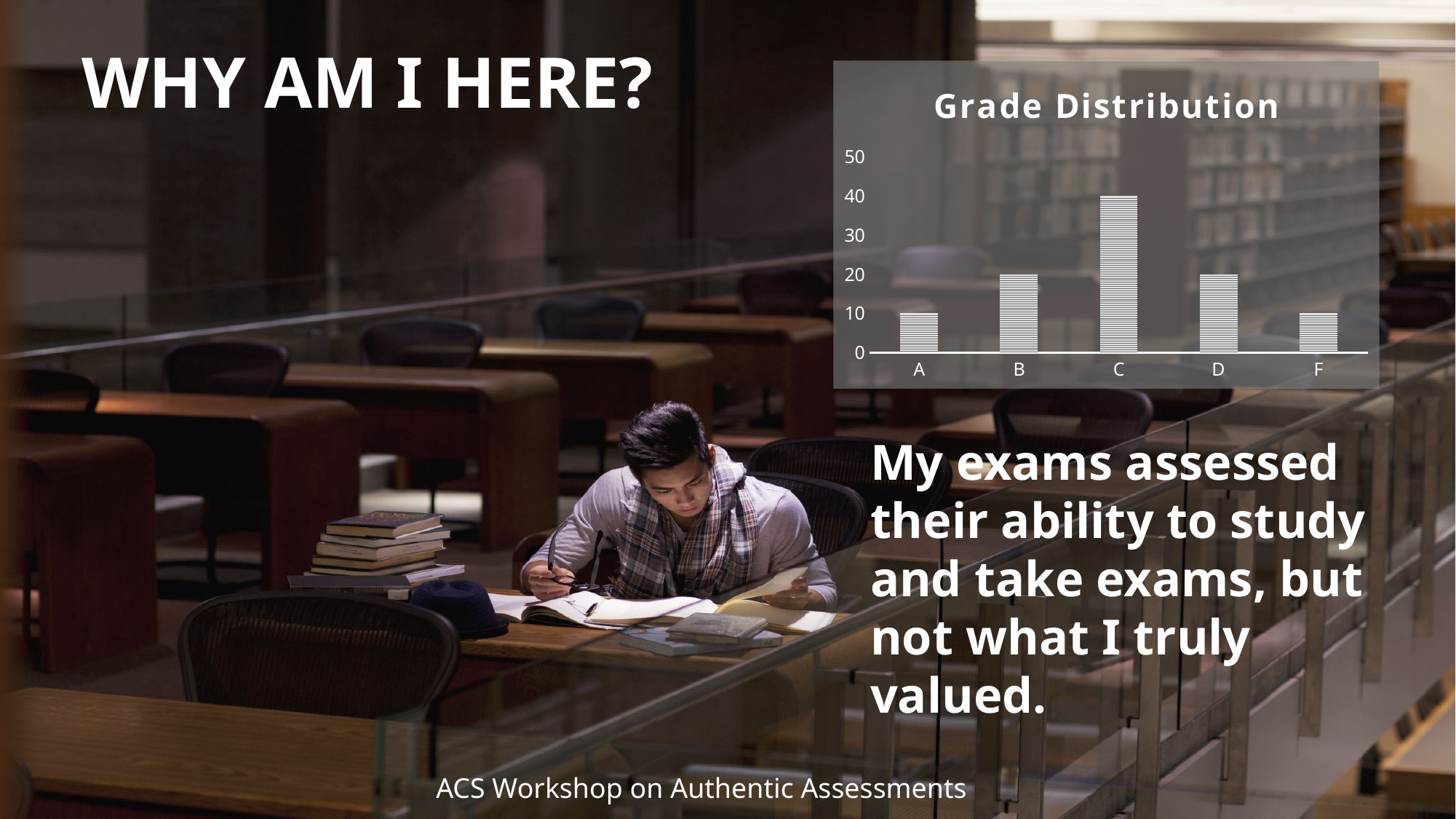
How many grade categories are shown on the x axis of the chart? 5 What is the value for grade B in the chart? 20 What is the highest value labelled on the y axis of the chart? 50 Is the value for grade C greater or less than 30? greater What kind of chart is shown on the slide? bar chart What is the difference between the value for C and the value for D? 20 Is the value for grade D greater or less than 30? less Which grade has the highest value in the chart? C What is the value for grade A in the chart? 10 Which is larger in the chart, the value for B or the value for F? B What is the value for grade C in the chart? 40 What is the title of the chart? Grade Distribution